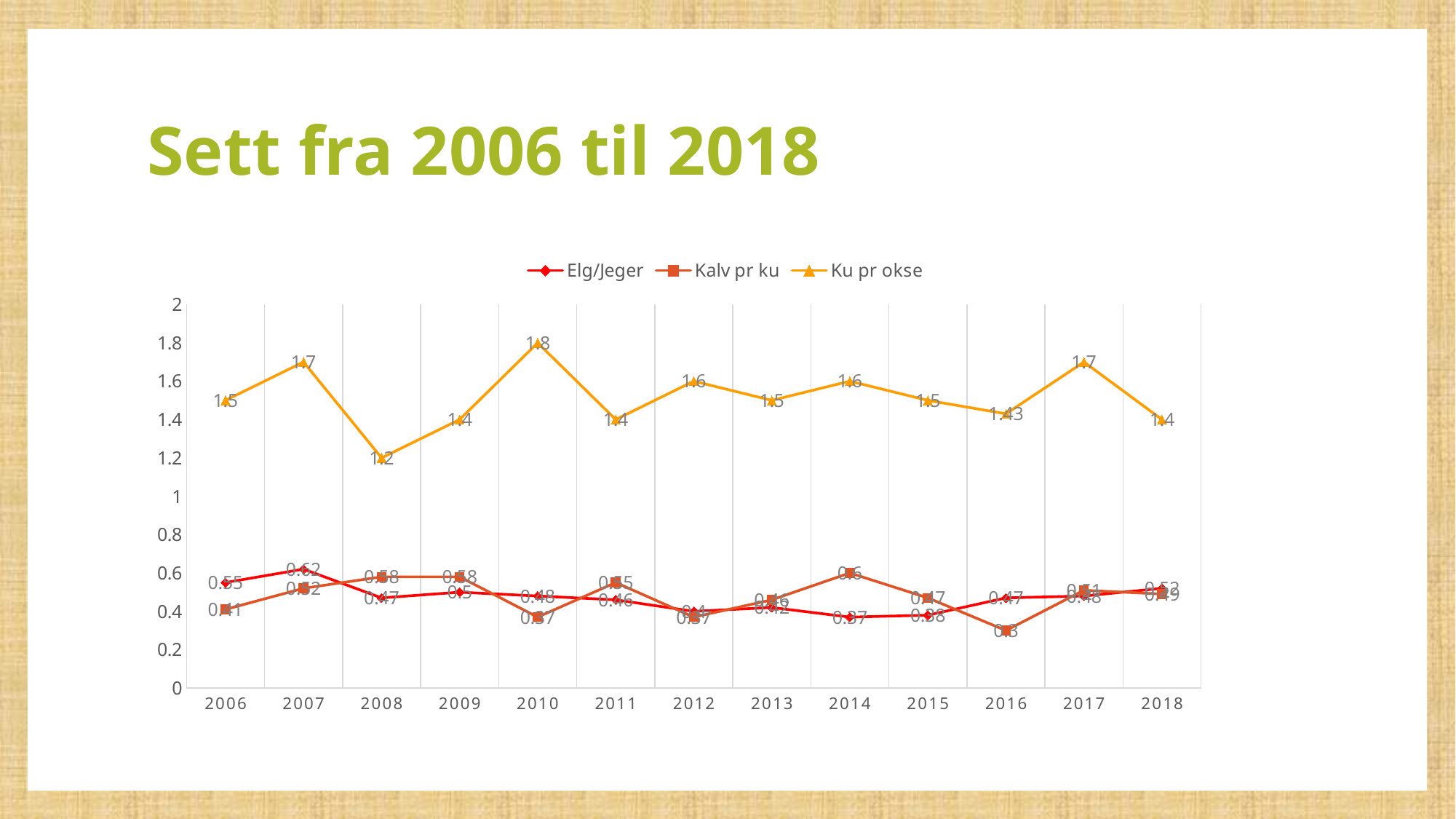
What is the difference between the highest and lowest Ku pr okse values? 0.6 What is the value of Kalv pr ku in 2006? 0.41 How many years are plotted along the x axis? 13 Is the value of Kalv pr ku in 2016 greater or less than 0.4? less What is the value of Ku pr okse in 2016? 1.43 What is the value of Ku pr okse in 2010? 1.8 In which year is Ku pr okse at its lowest? 2008 In which year is Ku pr okse at its highest? 2010 Which is larger, Ku pr okse in 2007 or in 2018? 2007 What type of chart is shown on the slide? line chart How many series does the legend list? 3 What is the value of Elg/Jeger in 2007? 0.62